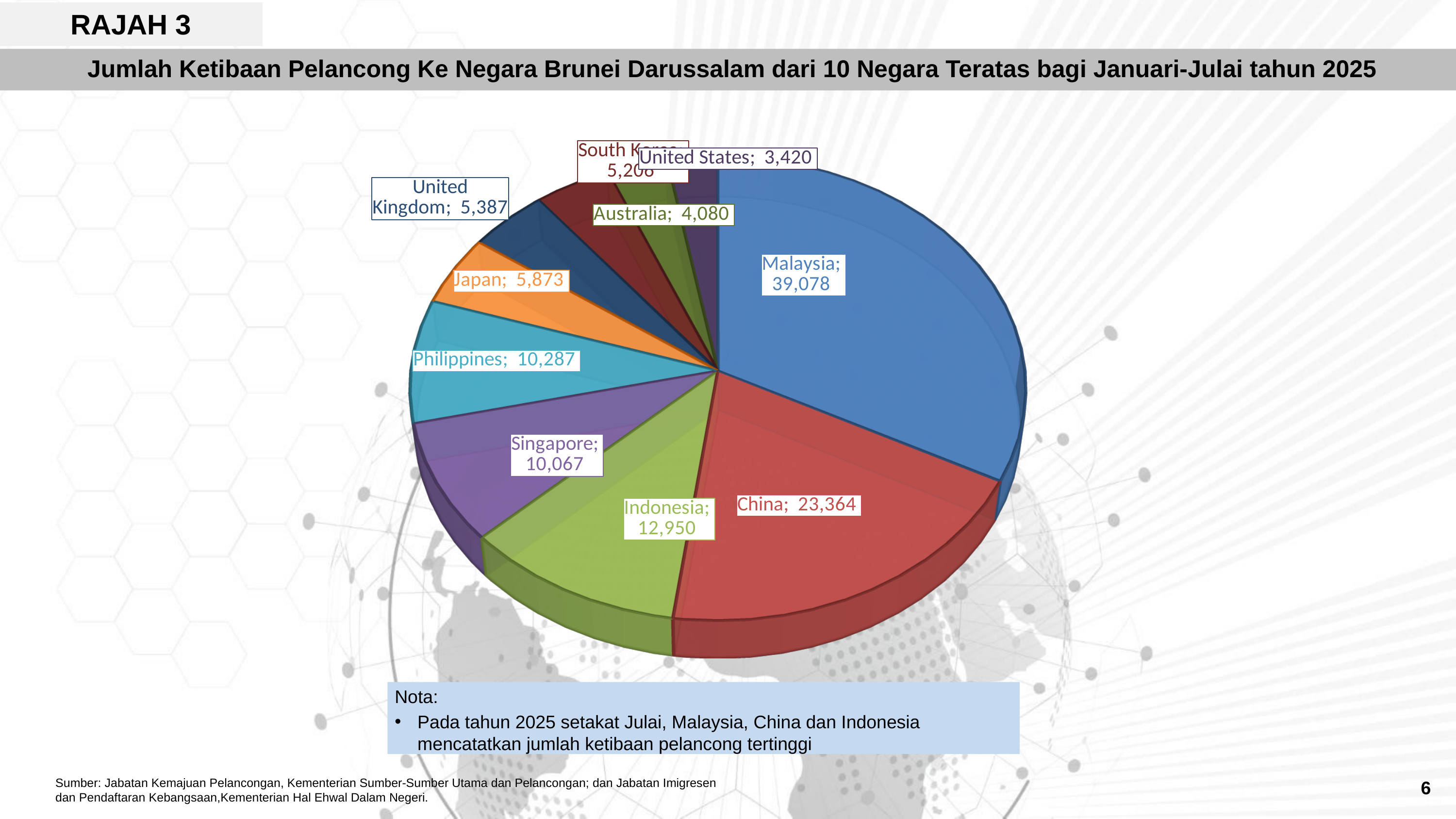
What is the value shown for Indonesia? 12,950 What kind of chart is shown on the slide? pie chart Which country has the largest slice of the pie? Malaysia What is the value shown for the Philippines? 10,287 Which country has the smallest slice of the pie? United States How many countries are shown in the pie chart? 10 What is the number of tourist arrivals from Malaysia? 39,078 What is the number of tourist arrivals from China? 23,364 Which is larger, the value for the Philippines or the value for Singapore? Philippines What is the value shown for the United Kingdom? 5,387 What is the difference between the values for Malaysia and China? 15,714 What is the difference between the values for Australia and the United States? 660